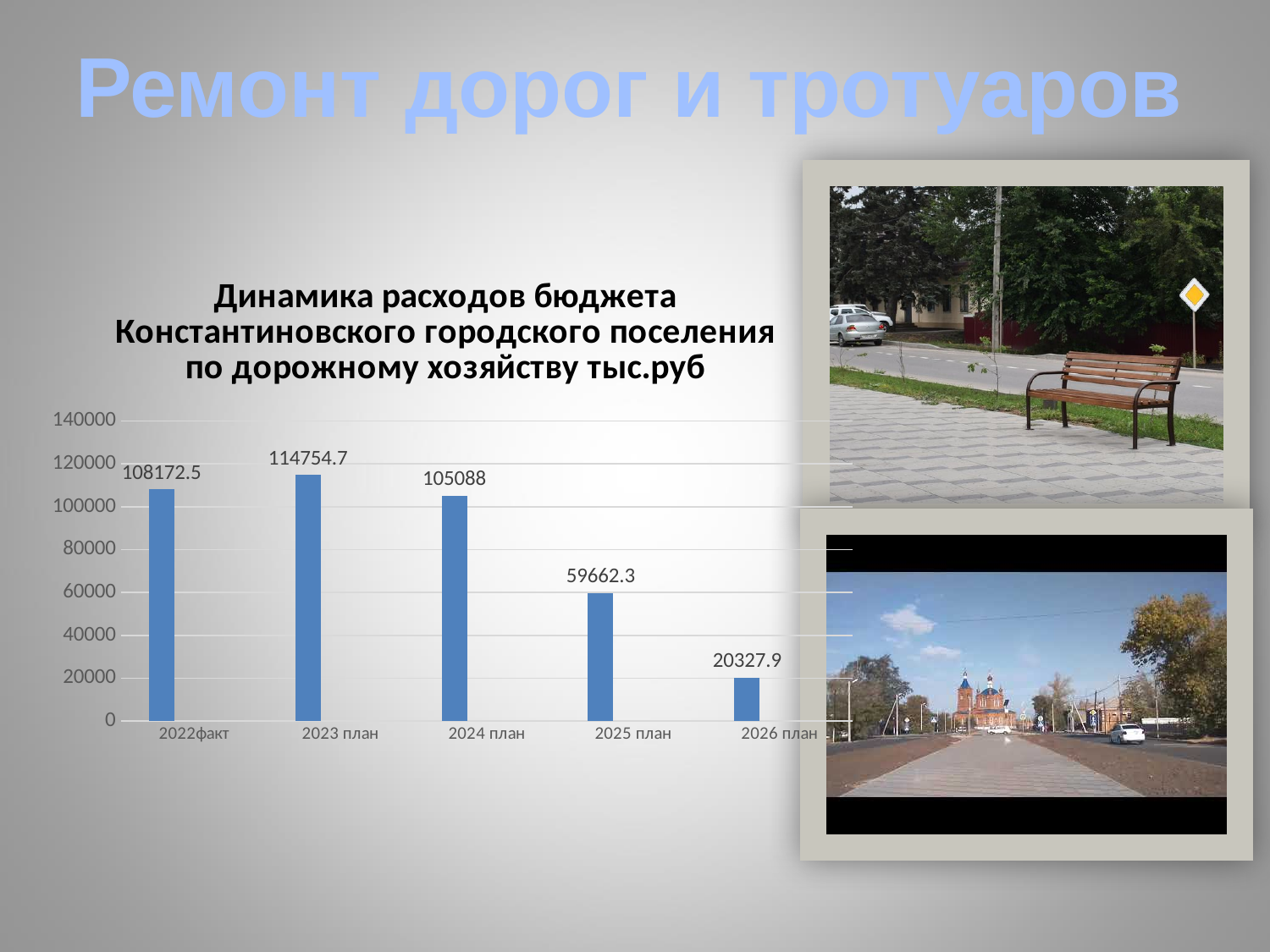
Which category has the lowest value? 2026 план What is the value for 2026 план? 20327.9 Is the value for 2025 план greater or less than 80000? less What is the difference between the values for 2025 план and 2026 план? 39334.4 What is the difference between the values for 2023 план and 2022факт? 6582.2 Do the values rise or fall from 2023 план to 2026 план? fall What is the value for 2024 план? 105088 What kind of chart is shown on the slide? bar chart Which is larger, the value for 2024 план or the value for 2025 план? 2024 план Which category has the highest value? 2023 план How many categories are shown on the x axis? 5 What is the value for 2022факт? 108172.5